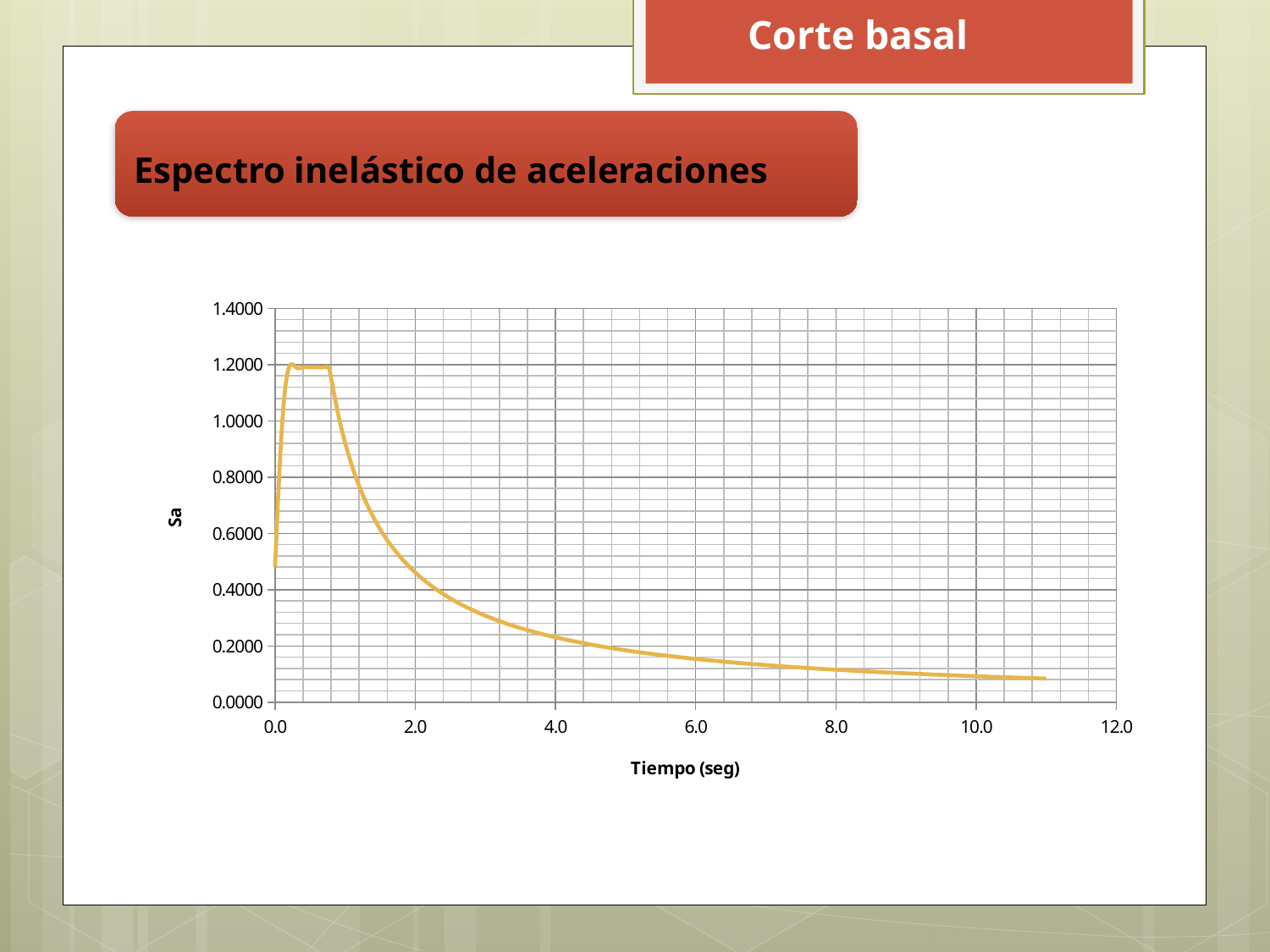
After the plateau near the start, does the value of Sa rise or fall as Tiempo increases? fall Is the value of Sa at Tiempo 0.0 greater or less than 0.6000? less Is the value of Sa at Tiempo 1.0 greater or less than 0.6000? greater Is the value of Sa at Tiempo 2.0 greater or less than 0.6000? less What is the label of the y axis of the chart? Sa What kind of chart is shown on the slide? line chart What is the label of the x axis of the chart? Tiempo (seg) Which is larger, the value of Sa at Tiempo 2.0 or at Tiempo 8.0? Tiempo 2.0